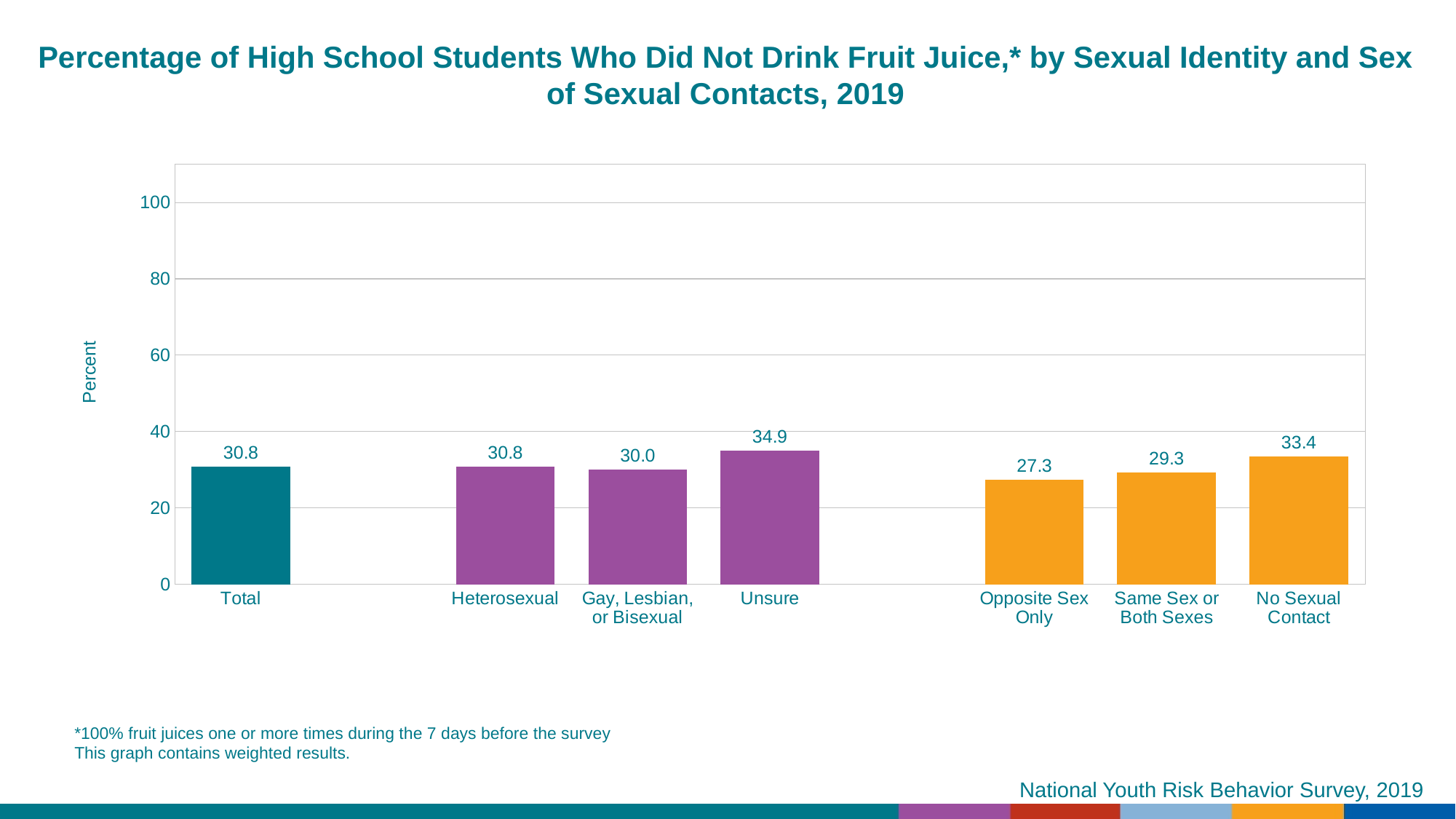
What kind of chart is shown on the slide? bar chart What is the difference between the values for No Sexual Contact and Opposite Sex Only? 6.1 What is the value for Gay, Lesbian, or Bisexual? 30.0 What is the label of the y axis? Percent What is the value for Opposite Sex Only? 27.3 What is the difference between the values for Unsure and Heterosexual? 4.1 Which category has the highest value? Unsure Which category has the lowest value? Opposite Sex Only Which is larger, the value for Same Sex or Both Sexes or the value for No Sexual Contact? No Sexual Contact What is the value for Unsure? 34.9 Is the value for Total greater or less than 40? less How many bars are plotted on the chart? 7